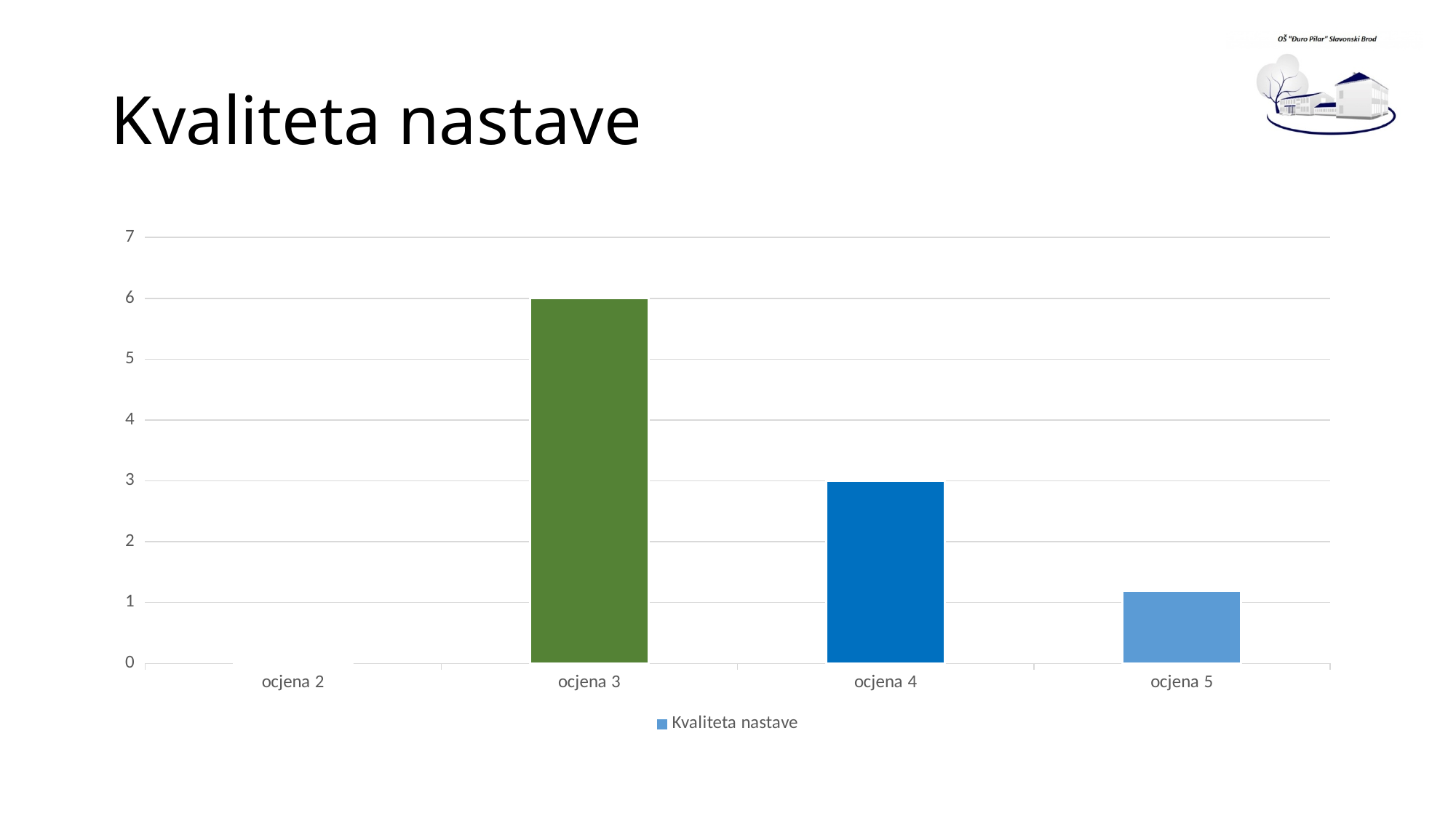
What type of chart is shown on the slide? bar chart What is the value for ocjena 3? 6 What is the name of the series shown in the legend? Kvaliteta nastave Do the values rise or fall from ocjena 3 to ocjena 5? fall Which is larger, the value for ocjena 4 or the value for ocjena 5? ocjena 4 What is the value for ocjena 4? 3 Which category has the tallest bar? ocjena 3 How many categories are shown on the x axis? 4 Is the value for ocjena 5 greater or less than 1? greater How many series does the legend list? 1 What is the difference between the values for ocjena 3 and ocjena 4? 3 Which category has no visible bar (a value of 0)? ocjena 2